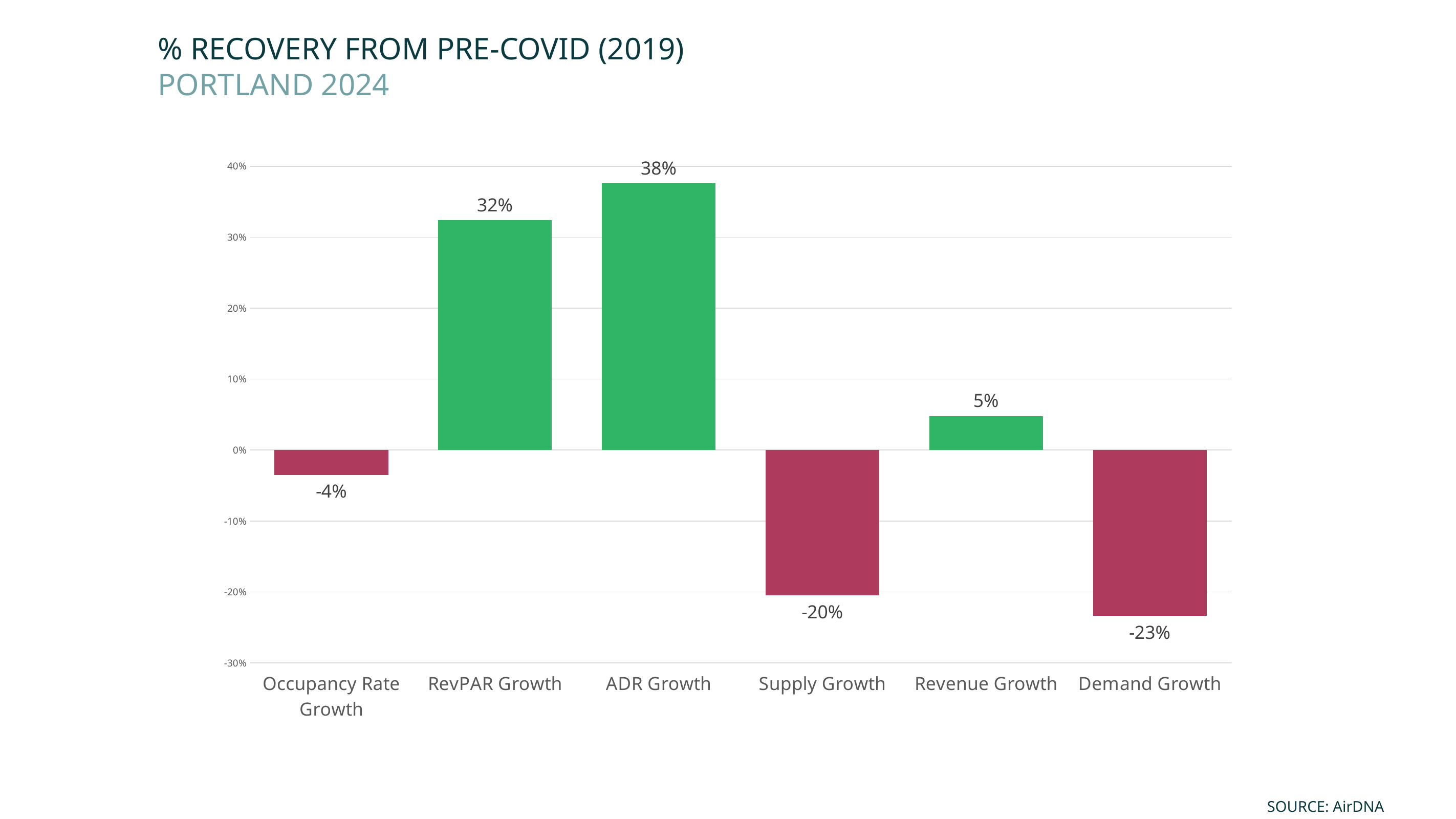
What is the value for Revenue Growth? 5% What is the source cited for the chart? AirDNA Is the value for Demand Growth greater or less than -10%? less Which category has the lowest value? Demand Growth Which is larger, the value for RevPAR Growth or the value for Revenue Growth? RevPAR Growth Which category has the highest value? ADR Growth What is the value for Supply Growth? -20% What kind of chart is shown on the slide? bar chart What is the value for Occupancy Rate Growth? -4% How many categories are shown on the x axis? 6 What is the difference between the values for ADR Growth and RevPAR Growth? 6% What is the value for ADR Growth? 38%